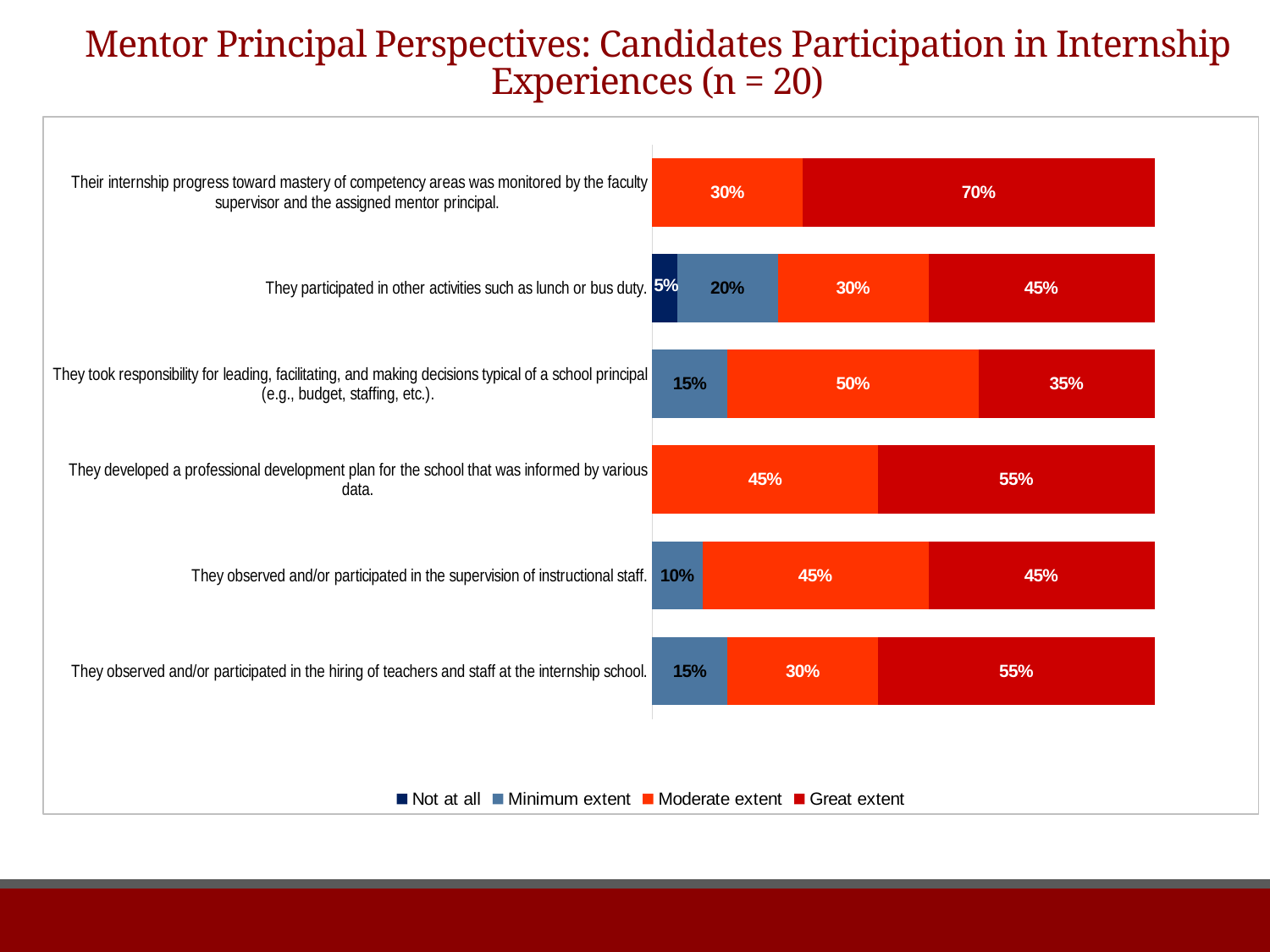
Which legend entry is shown in dark navy blue? Not at all How many series does the legend list? 4 How many categories (statements) are plotted in the chart? 6 Which statement has the lowest 'Great extent' value? They took responsibility for leading, facilitating, and making decisions typical of a school principal (e.g., budget, staffing, etc.). What kind of chart is shown on the slide? Stacked bar chart What is the 'Not at all' value for 'They participated in other activities such as lunch or bus duty'? 5% What is the difference between the 'Great extent' and 'Moderate extent' values for 'They observed and/or participated in the hiring of teachers and staff at the internship school'? 25% For 'They developed a professional development plan for the school that was informed by various data', which is larger: the 'Moderate extent' value or the 'Great extent' value? Great extent Which statement has the highest 'Great extent' value? Their internship progress toward mastery of competency areas was monitored by the faculty supervisor and the assigned mentor principal. What is the 'Moderate extent' value for 'They took responsibility for leading, facilitating, and making decisions typical of a school principal (e.g., budget, staffing, etc.)'? 50% What is the 'Minimum extent' value for 'They observed and/or participated in the supervision of instructional staff'? 10% What is the 'Great extent' value for 'Their internship progress toward mastery of competency areas was monitored by the faculty supervisor and the assigned mentor principal'? 70%